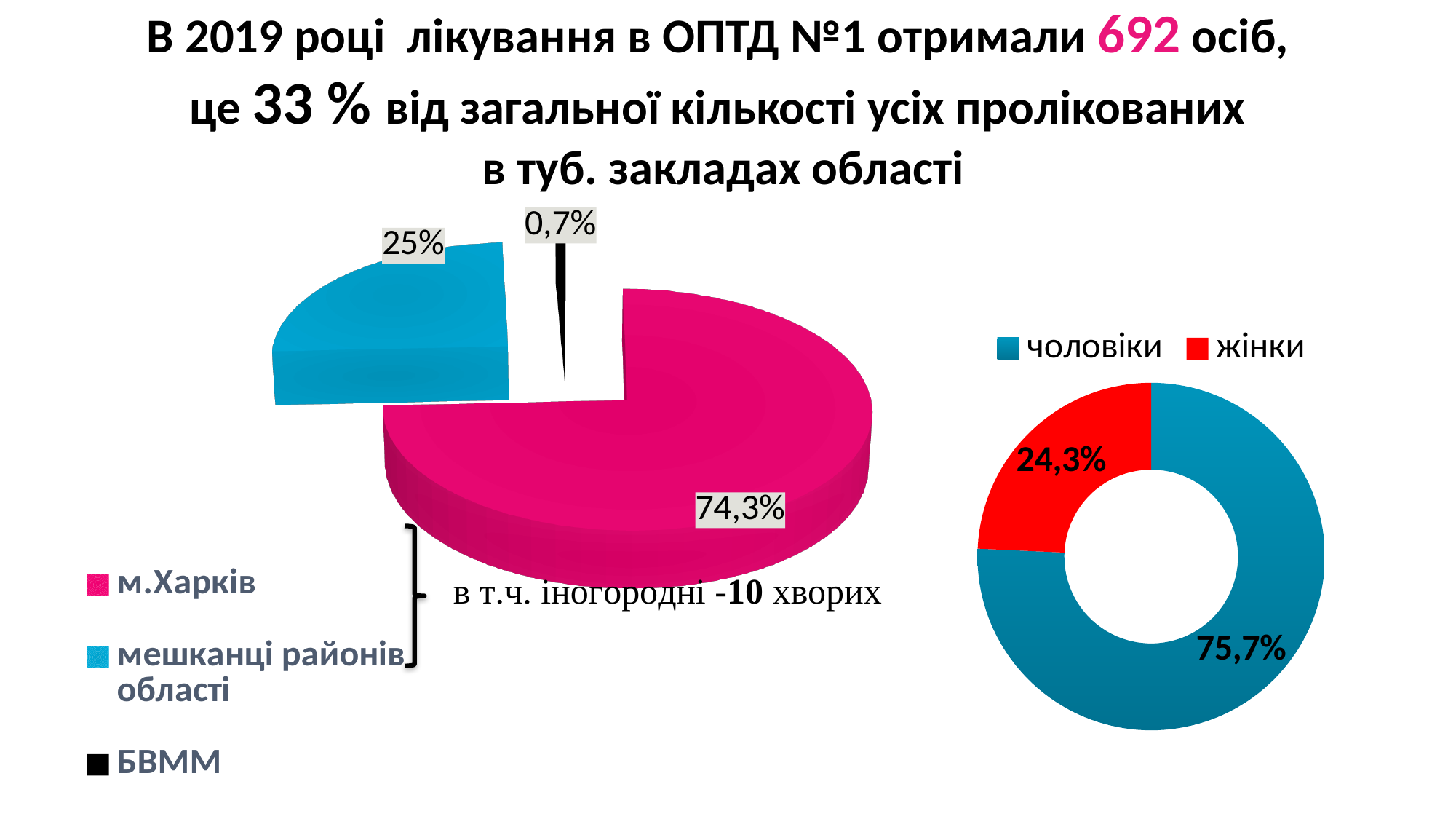
On the right doughnut chart, what is the share for жінки? 24,3% On the right doughnut chart, which is larger, чоловіки or жінки? чоловіки On the left pie chart, how many categories does the legend list? 3 On the left pie chart, what is the difference between the shares of м.Харків and мешканці районів області? 49,3% On the left pie chart, what is the share for м.Харків? 74,3% On the right doughnut chart, how many categories does the legend list? 2 On the right doughnut chart, what is the share for чоловіки? 75,7% On the left pie chart, what is the share for мешканці районів області? 25% On the left pie chart, what is the share for БВММ? 0,7% What type of chart is shown on the left of the slide? pie chart On the left pie chart, which category has the largest slice? м.Харків On the left pie chart, which category has the smallest slice? БВММ